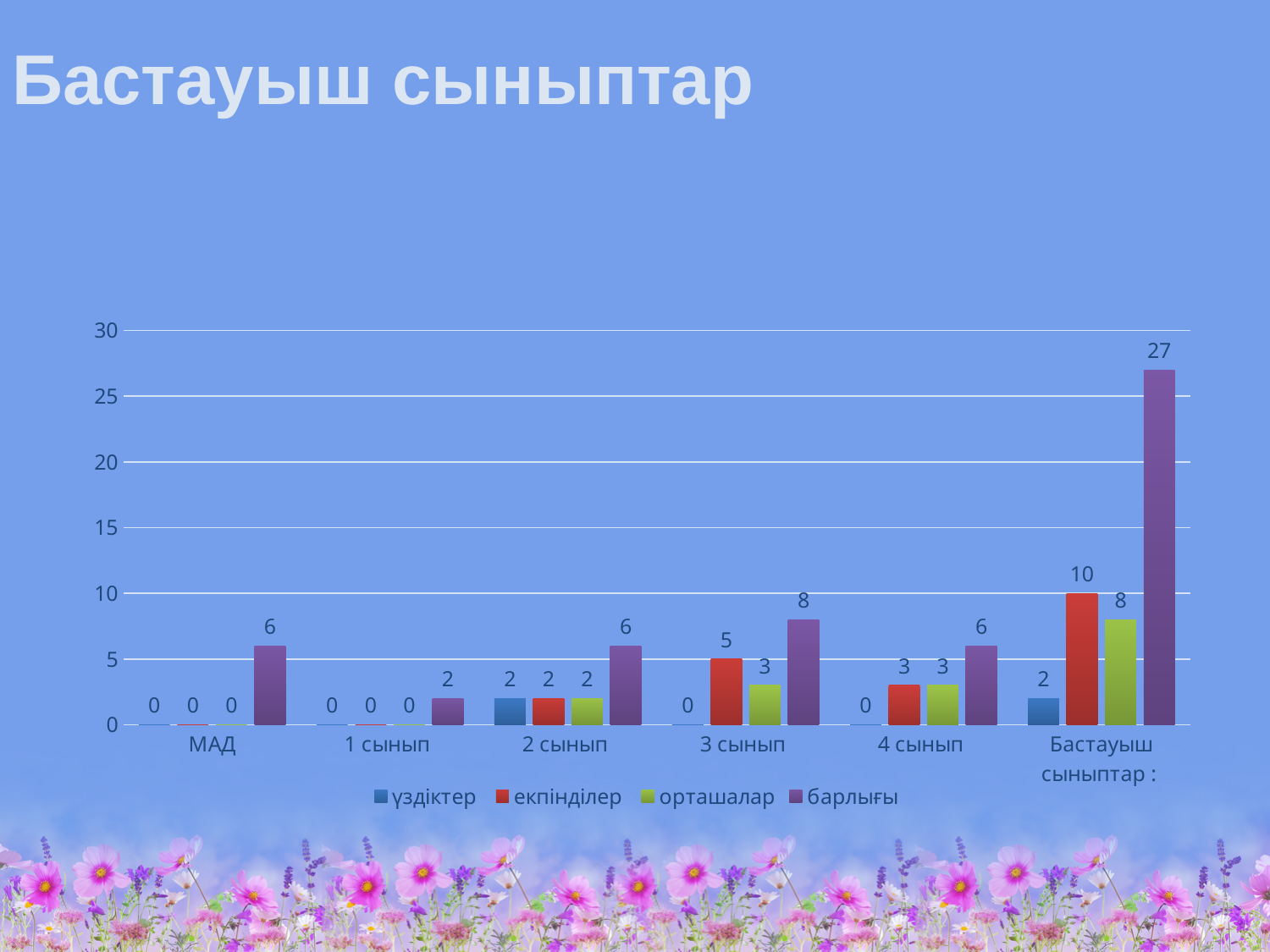
Which category has the lowest барлығы value? 1 сынып What is the difference between барлығы for Бастауыш сыныптар and барлығы for 3 сынып? 19 What is the value of екпінділер for Бастауыш сыныптар? 10 Which category has the highest барлығы value? Бастауыш сыныптар What is the title of the slide? Бастауыш сыныптар What is the value of орташалар for 4 сынып? 3 What type of chart is shown on the slide? bar chart Which is larger: екпінділер for 3 сынып or екпінділер for 4 сынып? екпінділер for 3 сынып Is the барлығы value for Бастауыш сыныптар greater or less than 25? greater How many categories are shown on the x axis? 6 How many series does the legend list? 4 What is the value of барлығы for 3 сынып? 8